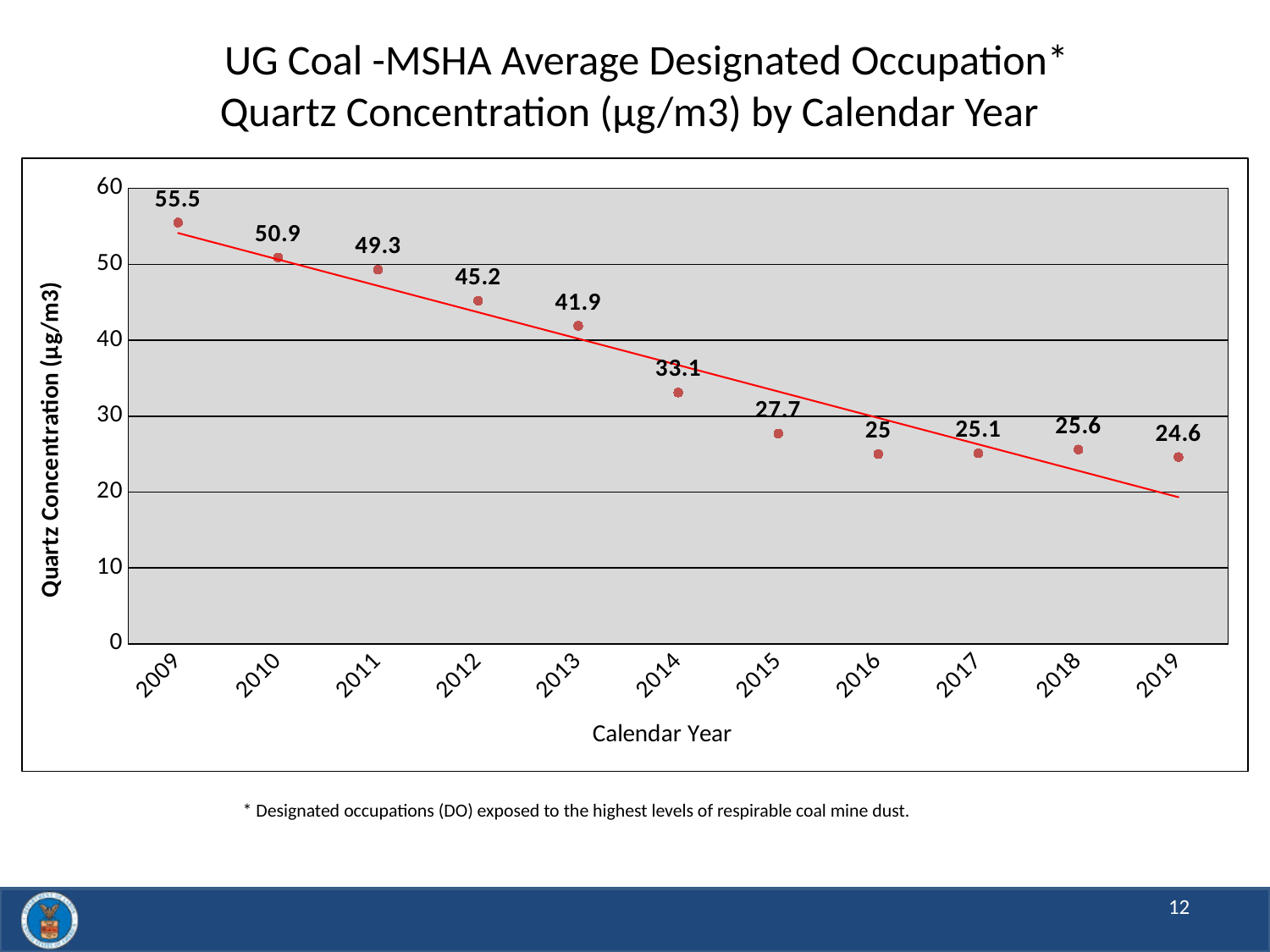
What is the difference between the quartz concentration in 2013 and in 2014? 8.8 How many calendar years are plotted on the chart? 11 What kind of chart is shown on the slide? Scatter chart with a trend line Which calendar year has the highest quartz concentration? 2009 Which year has a higher quartz concentration, 2012 or 2015? 2012 What is the quartz concentration value for 2009? 55.5 Is the quartz concentration for 2011 greater or less than 40? greater Do the quartz concentration values generally rise or fall from 2009 to 2019? Fall What is the quartz concentration value for 2014? 33.1 What is the quartz concentration value for 2019? 24.6 Which calendar year has the lowest quartz concentration? 2019 What is the difference between the quartz concentration in 2009 and in 2019? 30.9